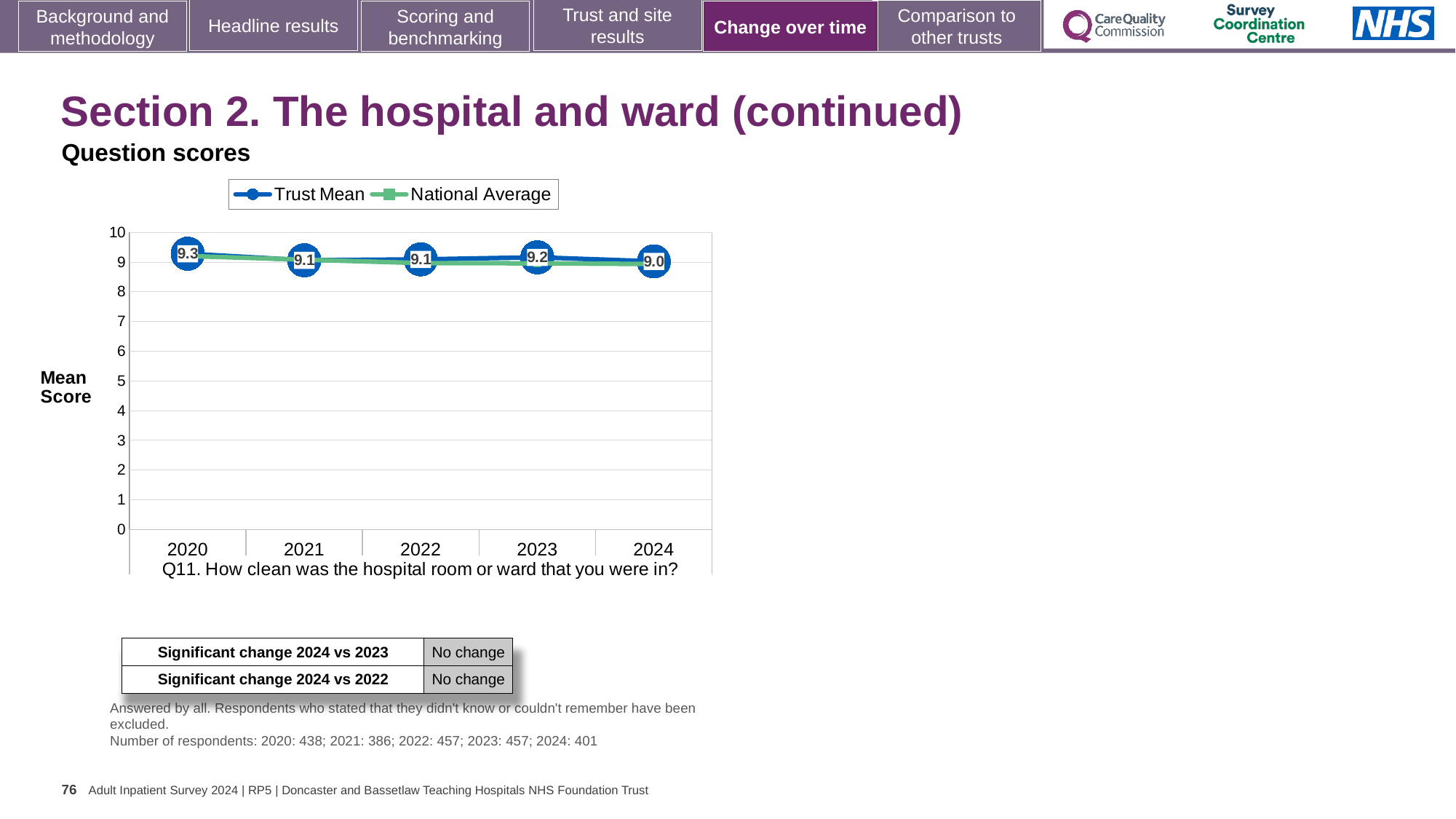
How many years are plotted on the x axis? 5 What is the difference between the Trust Mean in 2020 and in 2024? 0.3 What is the Trust Mean value for 2020? 9.3 Is the National Average value for 2020 greater or less than 8? greater What kind of chart is shown on the slide? Line chart In which year is the Trust Mean highest? 2020 What is the Trust Mean value for 2023? 9.2 Which survey question does the chart show scores for? Q11. How clean was the hospital room or ward that you were in? How many series does the legend list? 2 Which year has the larger Trust Mean, 2020 or 2024? 2020 What is the Trust Mean value for 2024? 9.0 In which year is the Trust Mean lowest? 2024